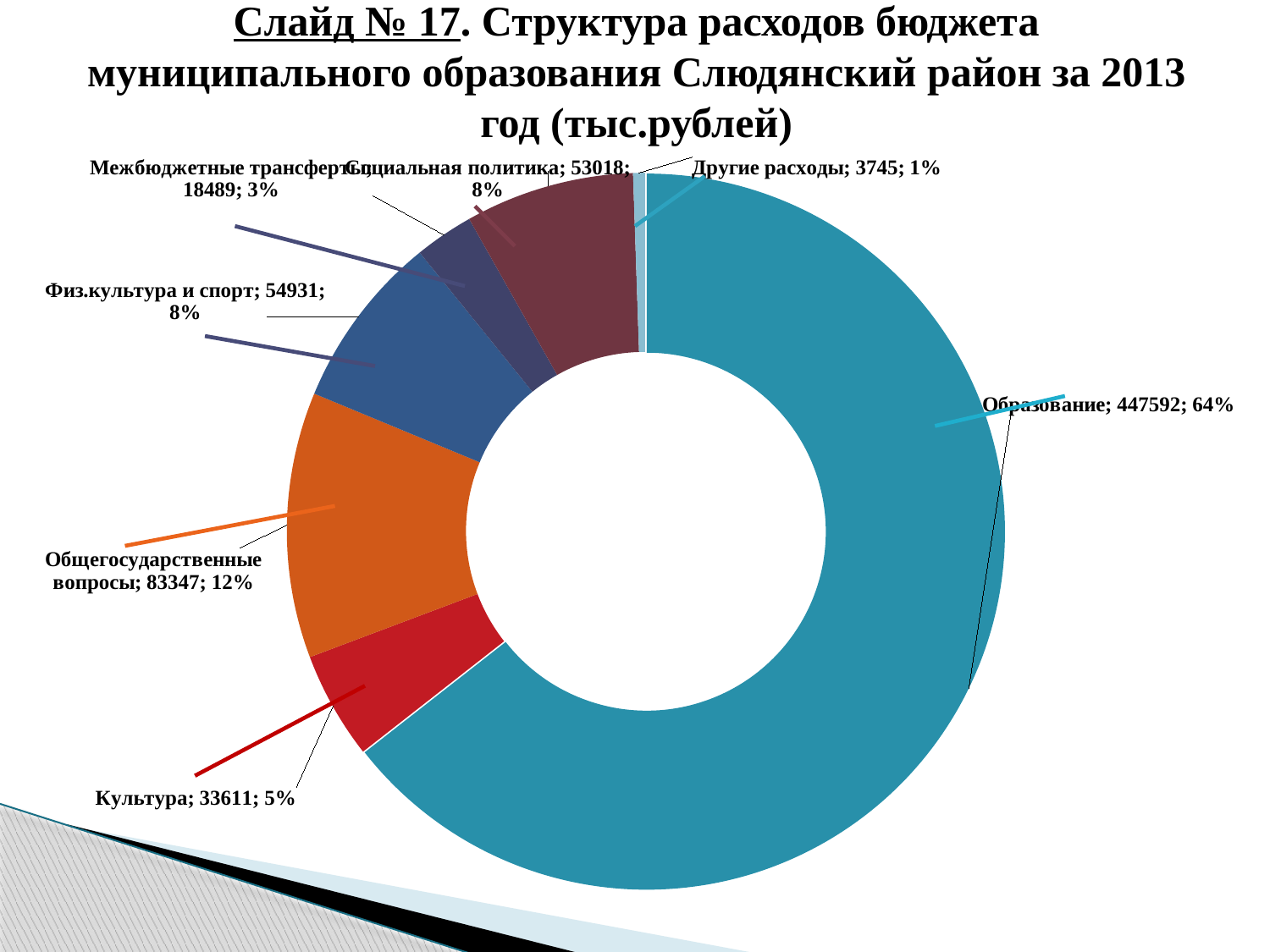
Which category has the largest expenditure? Образование What kind of chart is shown on the slide? Doughnut (pie) chart What is the value for Образование (thousand rubles)? 447592 How many expenditure categories are shown in the chart? 7 What share of the budget expenditures does Образование account for? 64% What is the difference between Физ.культура и спорт and Социальная политика? 1913 What is the value for Другие расходы? 3745 What share does Культура account for? 5% Which category has the smallest expenditure? Другие расходы Which is larger: Межбюджетные трансферты or Культура? Культура What is the value for Общегосударственные вопросы? 83347 What share does Межбюджетные трансферты account for? 3%